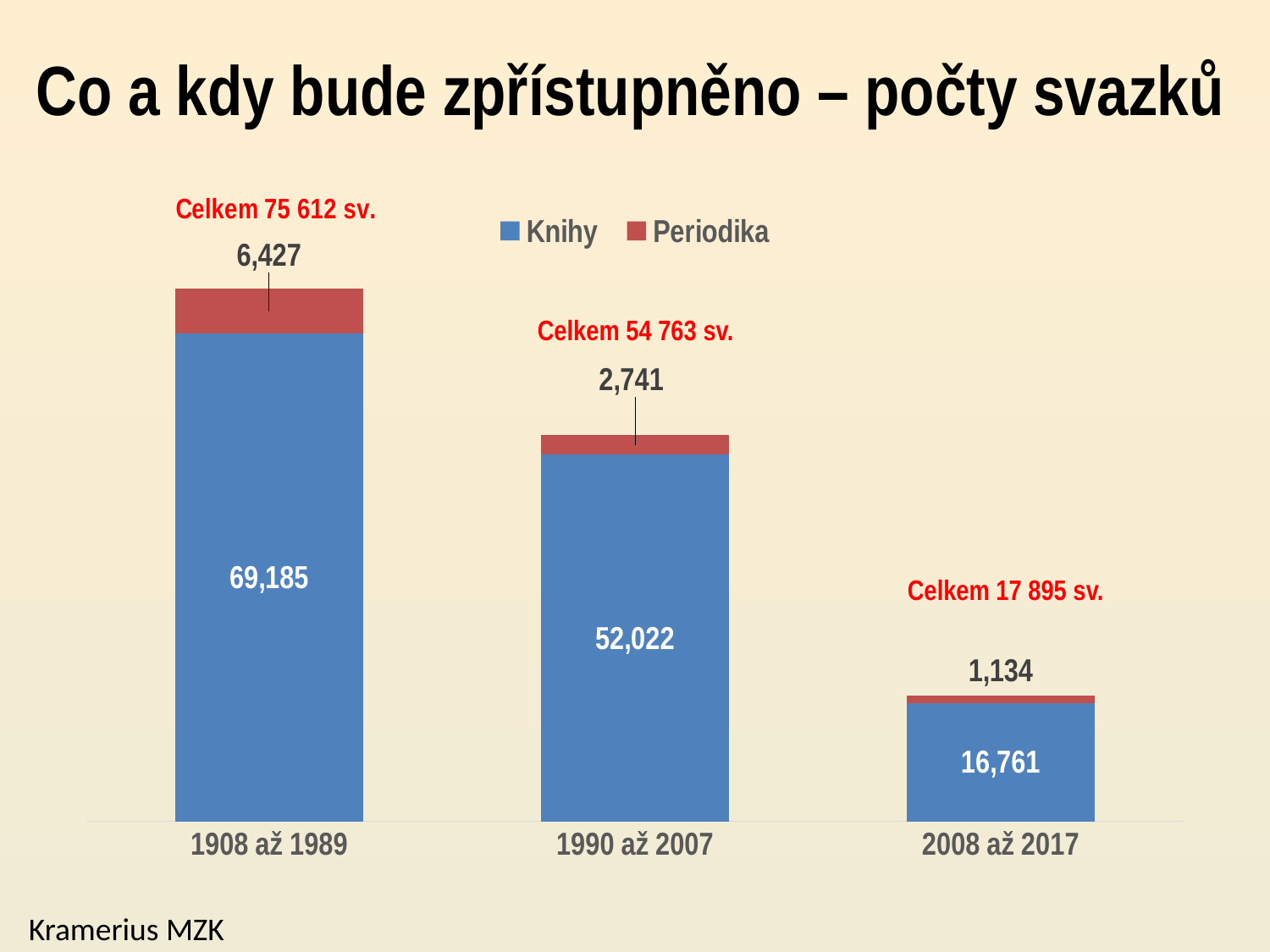
What is the total of the stacked bar for 1990 až 2007? 54,763 How many periods are shown on the x axis? 3 What is the value of Knihy for 2008 až 2017? 16,761 What is the value of Knihy for 1908 až 1989? 69,185 What is the value of Periodika for 2008 až 2017? 1,134 What is the value of Periodika for 1990 až 2007? 2,741 Which period has the lowest value for Periodika? 2008 až 2017 Which is larger: Periodika for 1908 až 1989 or Periodika for 1990 až 2007? Periodika for 1908 až 1989 What kind of chart is shown on the slide? Stacked bar chart What is the difference between the Knihy values for 1908 až 1989 and 1990 až 2007? 17,163 Which period has the highest value for Knihy? 1908 až 1989 How many series does the legend list? 2